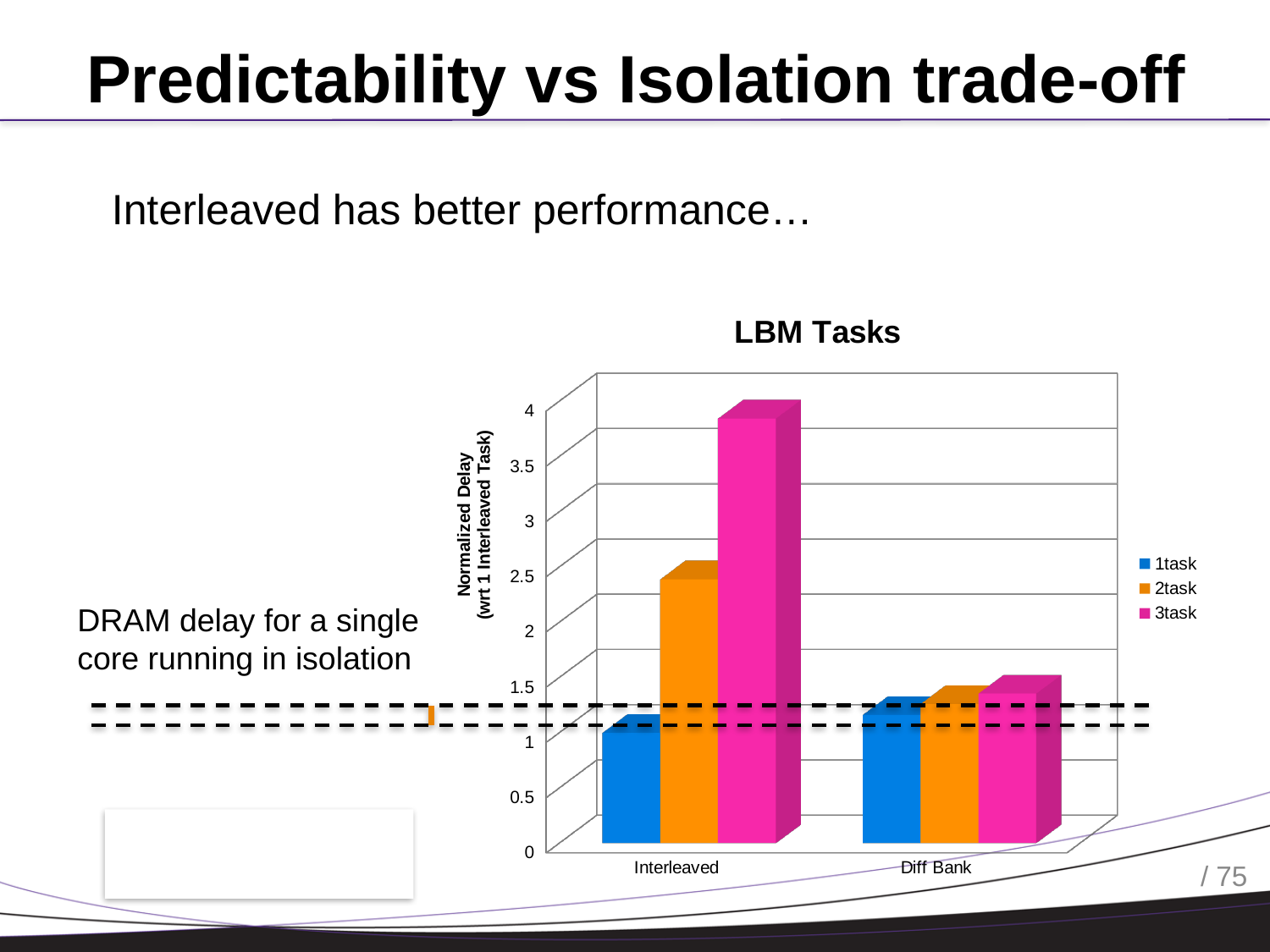
Is the 3task value for Diff Bank greater or less than 2? less How many series does the chart legend list? 3 What is the label of the vertical axis of the chart? Normalized Delay (wrt 1 Interleaved Task) Is the 3task value for Interleaved greater or less than 3.5? greater Which series has the highest bar in the Interleaved category? 3task Which category has the larger 2task value, Interleaved or Diff Bank? Interleaved Which category has the larger 3task value, Interleaved or Diff Bank? Interleaved How many categories are shown on the x axis of the chart? 2 What kind of chart is shown on the slide? bar chart What is the title of the chart? LBM Tasks Which series has the lowest bar in the Interleaved category? 1task Is the 2task value for Interleaved greater or less than 2? greater